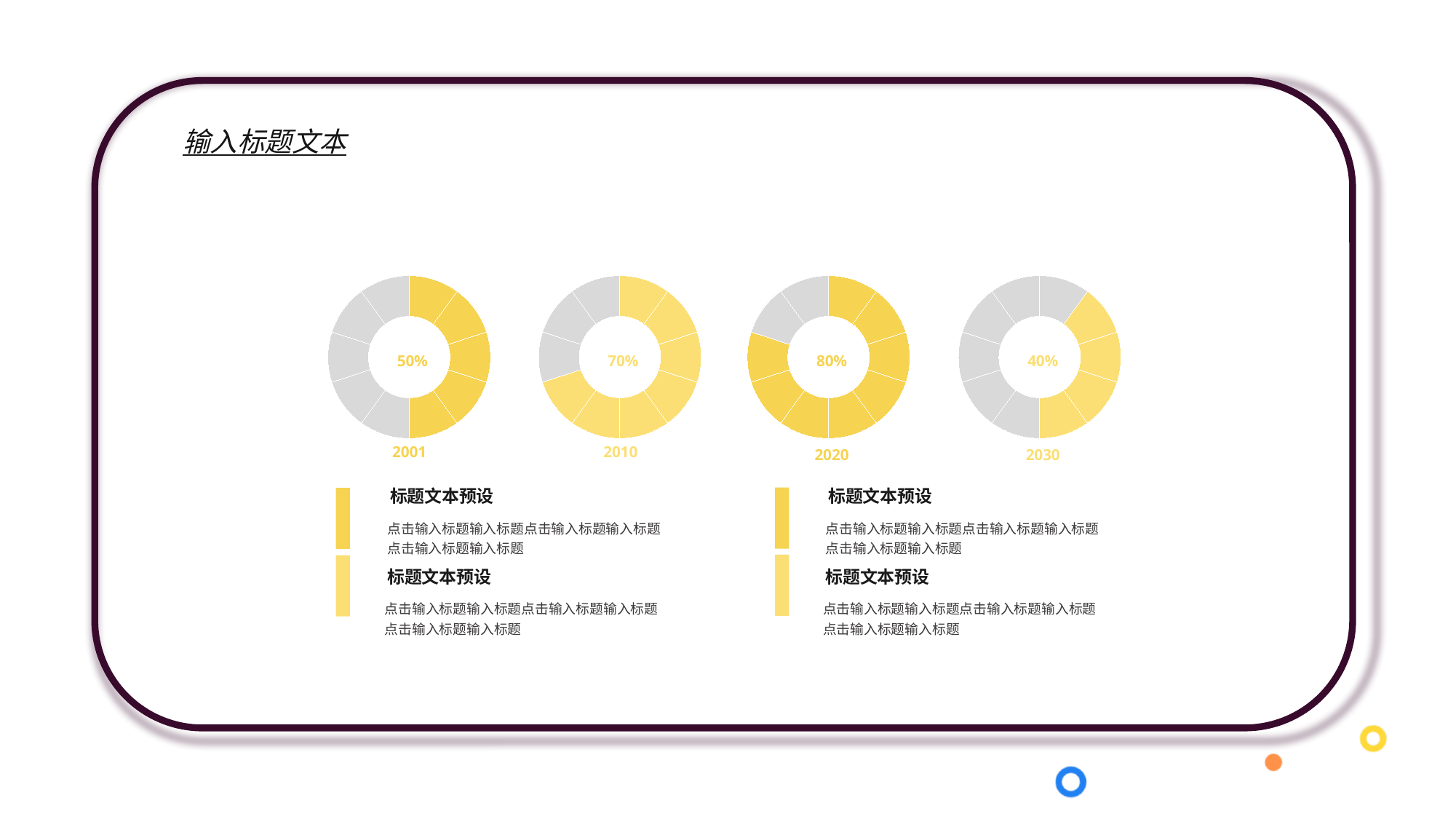
What colour is used for the filled portion of each donut chart? Yellow What percentage is shown in the centre of the donut chart labelled 2020? 80% Do the percentages rise or fall from the 2020 donut chart to the 2030 donut chart? Fall Which year's donut chart shows the lowest percentage? 2030 What kind of chart is used to show the percentage for each year? Donut chart Which is larger, the percentage shown for 2010 or the percentage shown for 2030? 2010 What percentage is shown in the centre of the donut chart labelled 2010? 70% Which year's donut chart shows the highest percentage? 2020 How many donut charts are shown on the slide? 4 What is the difference between the percentage shown for 2020 and the percentage shown for 2001? 30% What percentage is shown in the centre of the donut chart labelled 2001? 50% What percentage is shown in the centre of the donut chart labelled 2030? 40%